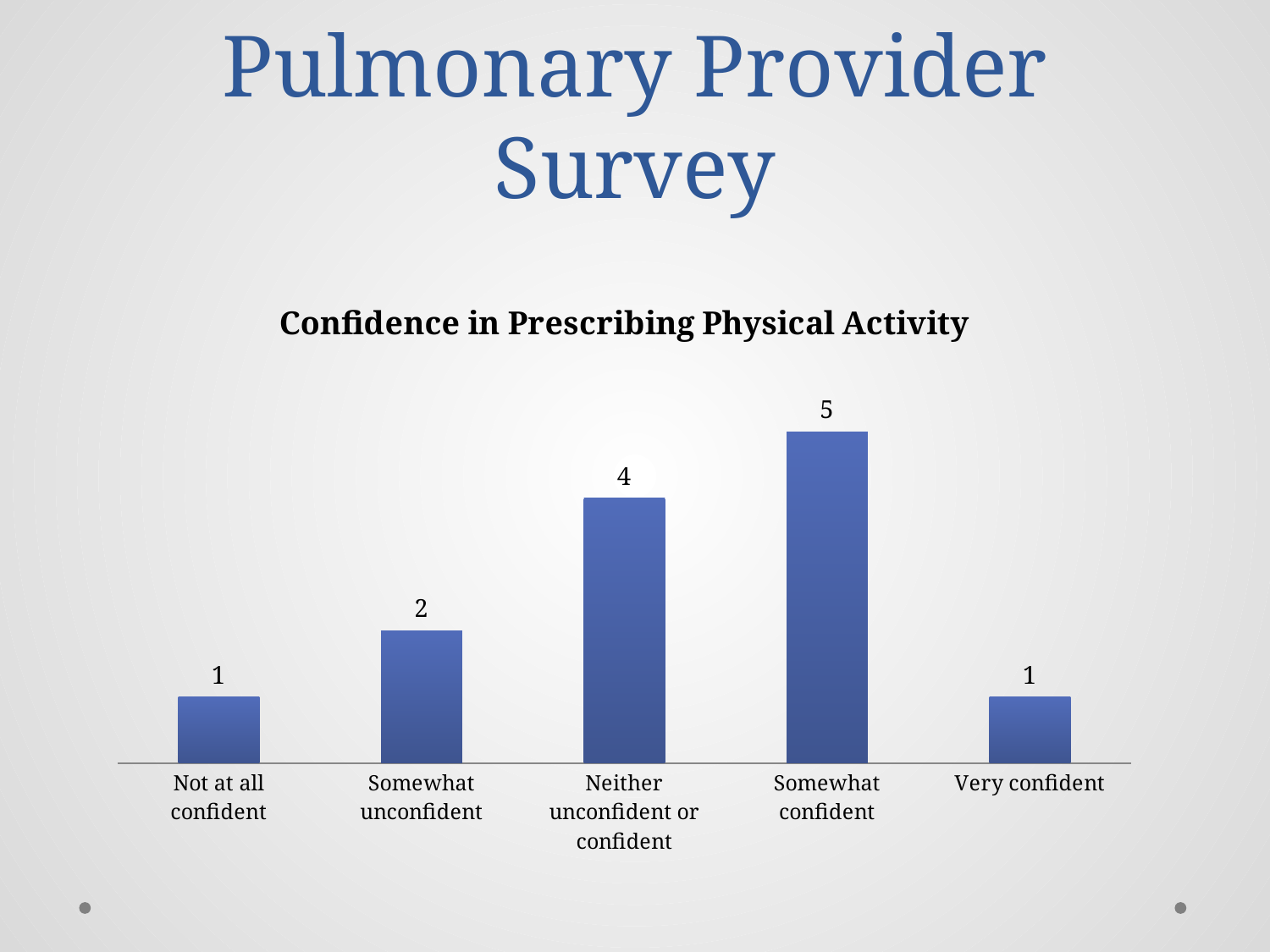
What is the total of all the values shown in the chart? 13 Which is larger, the value for "Somewhat unconfident" or the value for "Very confident"? Somewhat unconfident What is the value for "Somewhat confident"? 5 What is the difference between the values for "Neither unconfident or confident" and "Not at all confident"? 3 What kind of chart is shown on the slide? Bar chart What is the title of the chart? Confidence in Prescribing Physical Activity Which category has the highest value? Somewhat confident What is the value for "Very confident"? 1 What is the value for "Somewhat unconfident"? 2 What is the difference between the values for "Somewhat confident" and "Somewhat unconfident"? 3 How many categories are shown on the x axis? 5 What is the value for "Neither unconfident or confident"? 4